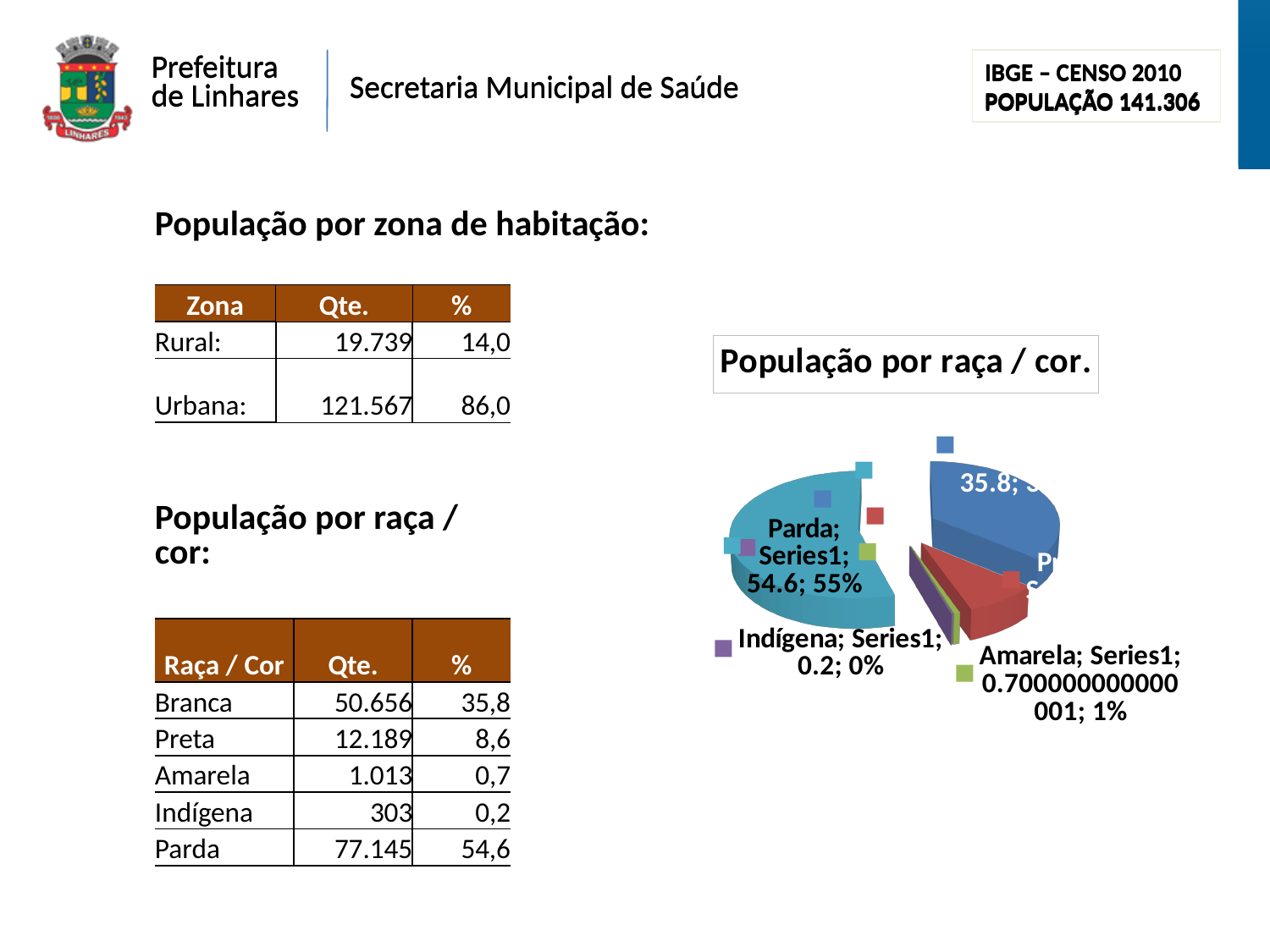
Which category has the smallest slice in the pie chart? Indígena In the pie chart, what percentage share is shown for Parda? 55% In the pie chart, what is the difference between the value for Parda and the value for Indígena? 54.4 What is the title of the chart on the slide? População por raça / cor. In the pie chart, what value is shown for Parda? 54.6 Which category has the largest slice in the pie chart? Parda In the pie chart, what value is shown for Indígena? 0.2 In the pie chart, what percentage share is shown for Amarela? 1% What kind of chart is shown on the slide? pie chart How many slices does the pie chart have? 5 In the pie chart, which is larger, the slice for Parda or the slice for Amarela? Parda In the pie chart, what percentage share is shown for Indígena? 0%